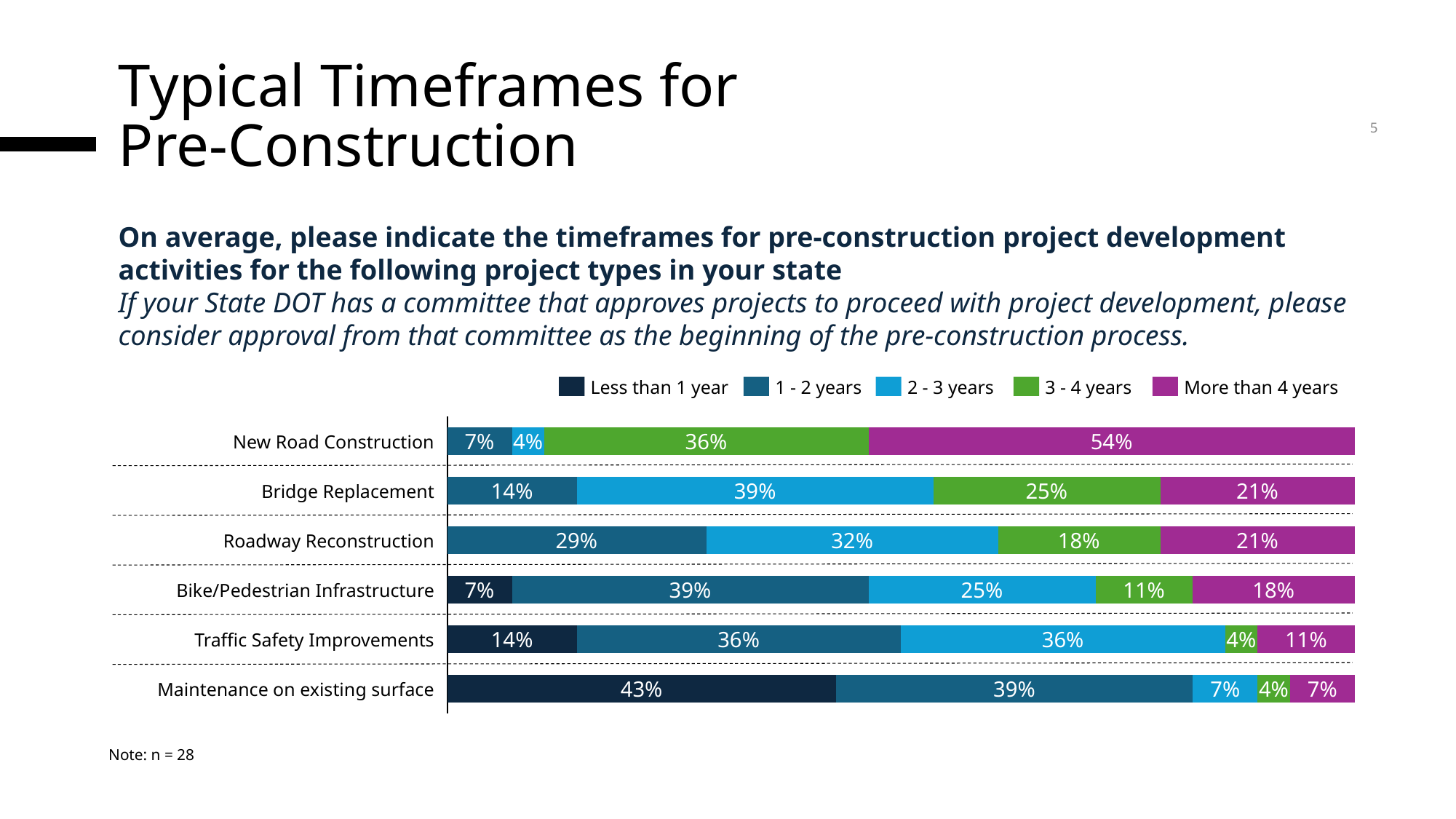
What is the difference between the 'More than 4 years' values for New Road Construction and Bridge Replacement? 33 percentage points What is the '1 - 2 years' value for Roadway Reconstruction? 29% What kind of chart is shown on the slide? Stacked bar chart How many project types are shown in the chart? 6 What is the value for '2 - 3 years' for Bridge Replacement? 39% What percentage of respondents indicated 'More than 4 years' for New Road Construction? 54% Which project type has the lowest '3 - 4 years' share? Traffic Safety Improvements and Maintenance on existing surface (both 4%) Which project type has the highest 'More than 4 years' share? New Road Construction How many series does the legend list? 5 What is the 'Less than 1 year' value for Maintenance on existing surface? 43% What is the sample size noted below the chart? n = 28 Which is larger: the '1 - 2 years' value for Bike/Pedestrian Infrastructure or for Traffic Safety Improvements? Bike/Pedestrian Infrastructure